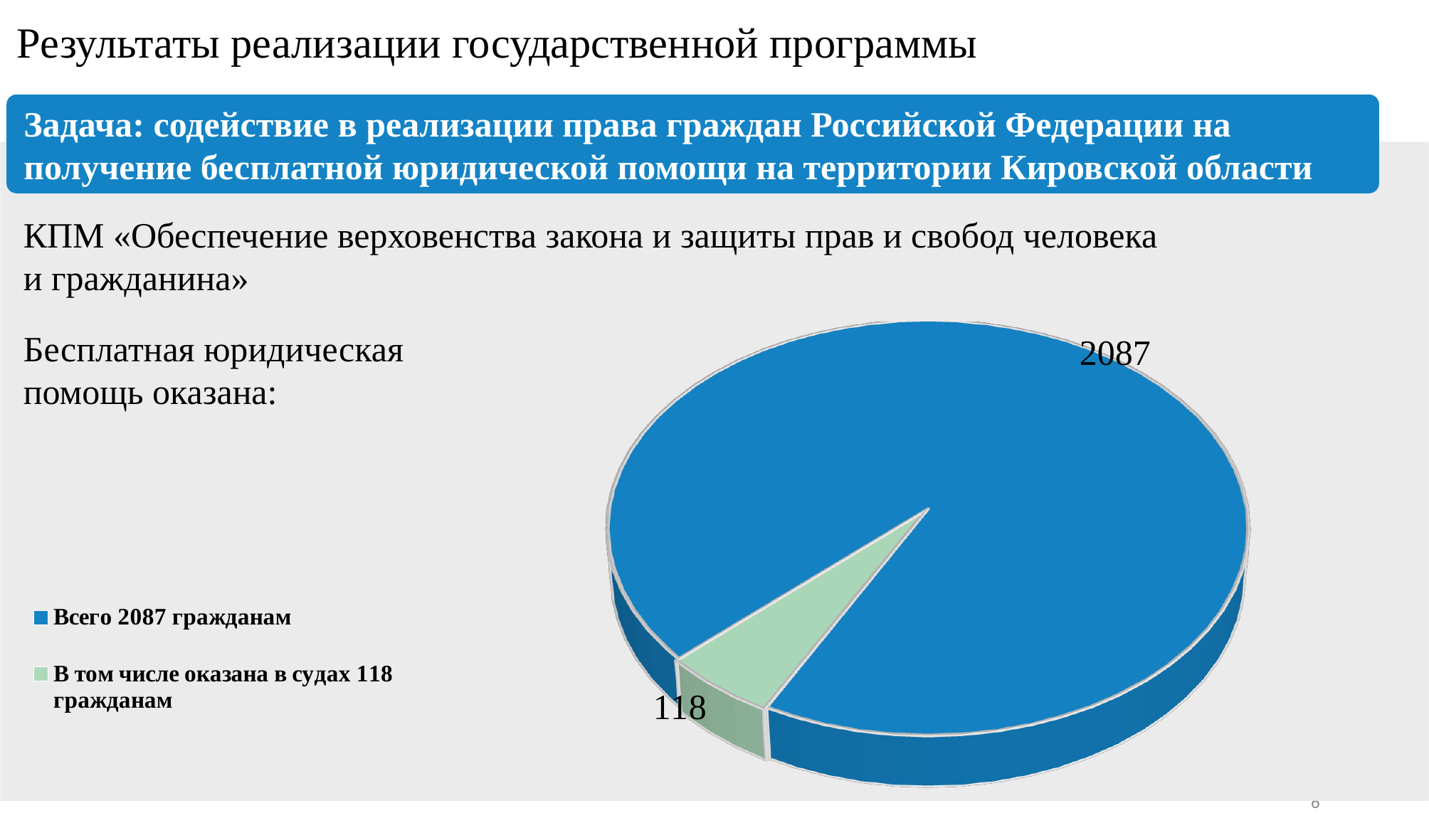
Which is larger: the slice labelled 2087 or the slice labelled 118? The slice labelled 2087 What colour is the slice labelled 2087? Blue What kind of chart is shown on the slide? Pie chart What is the difference between the values of the two slices, 2087 and 118? 1969 What colour is the slice labelled 118? Green How many slices does the pie chart have? 2 What value is shown for the slice "В том числе оказана в судах 118 гражданам"? 118 Which slice of the pie chart is the smallest? В том числе оказана в судах 118 гражданам What value is shown for the slice "Всего 2087 гражданам"? 2087 Which slice of the pie chart is the largest? Всего 2087 гражданам How many entries does the legend of the pie chart list? 2 Is the value of the smaller slice greater or less than 1000? less